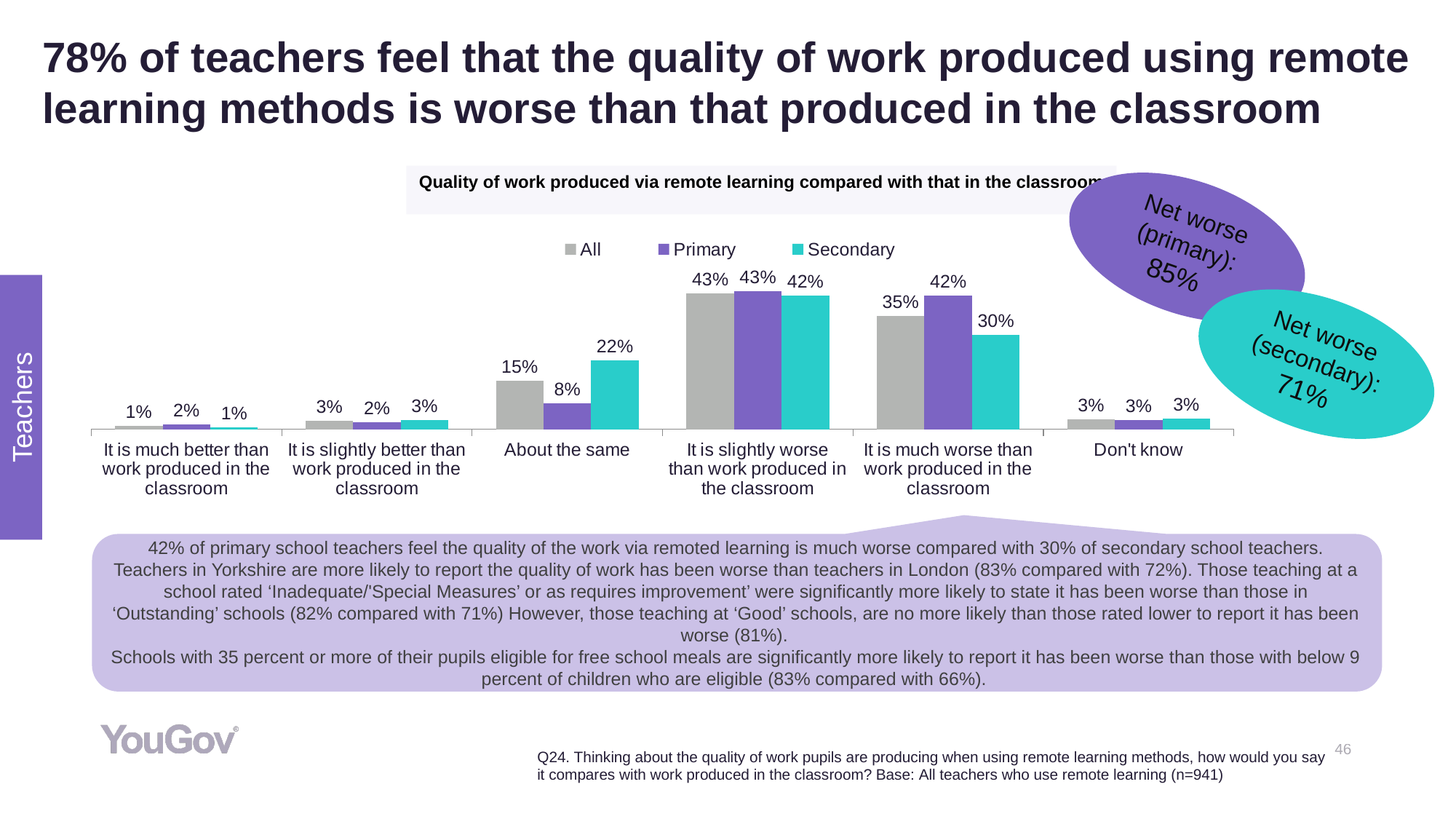
What is the title of the chart? Quality of work produced via remote learning compared with that in the classroom What is the value for Secondary in the 'About the same' category? 22% Which series is shown in grey in the chart? All How many series does the chart legend list? 3 How many categories are shown on the x axis of the chart? 6 What is the difference between the Primary and Secondary values in the 'It is much worse than work produced in the classroom' category? 12% Which category has the lowest value for the All series? It is much better than work produced in the classroom What is the value for Primary in the 'It is much worse than work produced in the classroom' category? 42% What is the value for All in the 'It is slightly worse than work produced in the classroom' category? 43% In the 'About the same' category, which is larger: the Primary value or the Secondary value? Secondary Which category has the highest value for the Secondary series? It is slightly worse than work produced in the classroom What kind of chart is shown on the slide? Bar chart